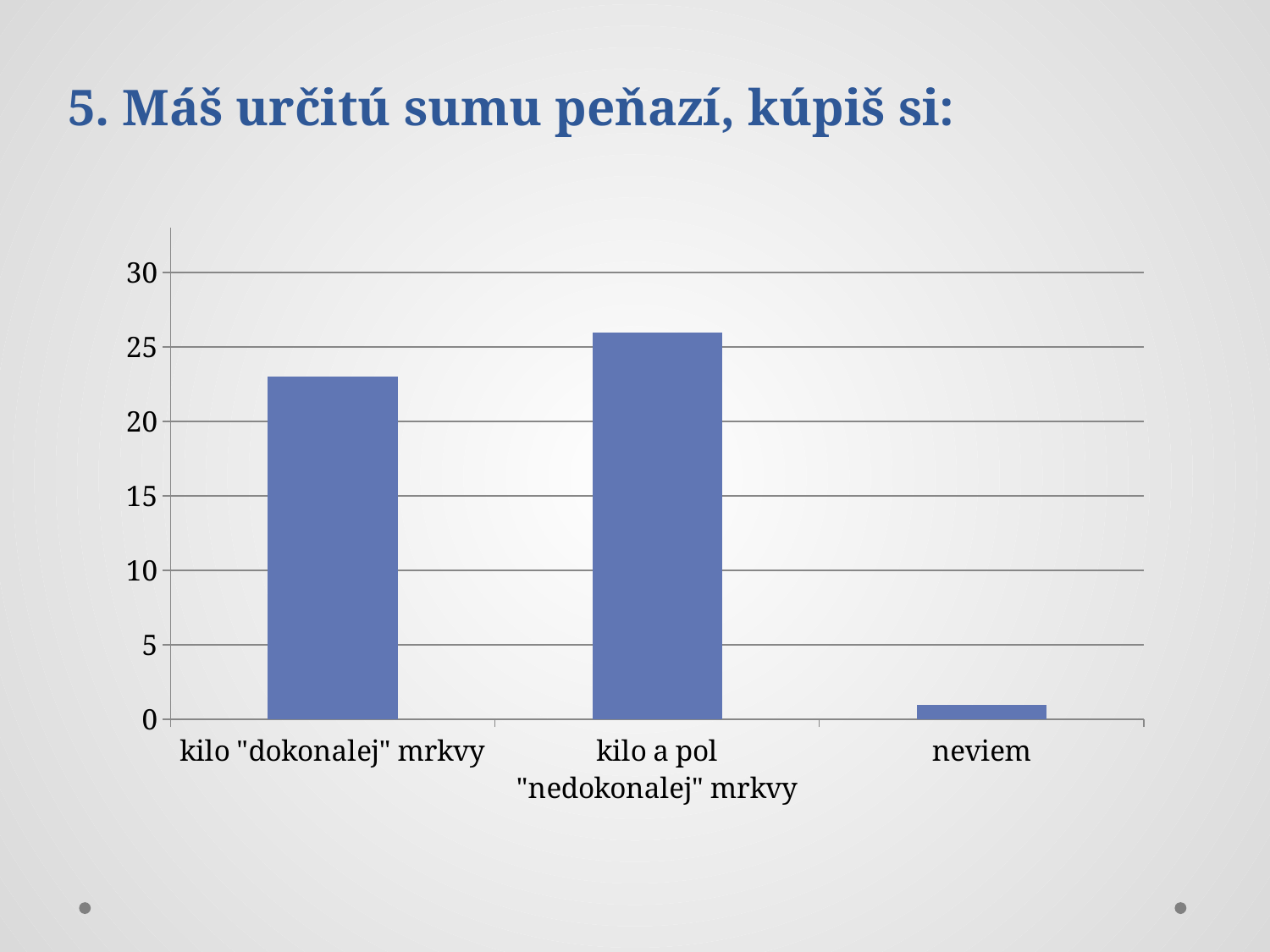
Is the value for kilo "dokonalej" mrkvy greater or less than 25? less Is the value for neviem greater or less than 5? less Which category has the highest bar? kilo a pol "nedokonalej" mrkvy How many categories are shown on the x axis of the chart? 3 Is the value for kilo "dokonalej" mrkvy greater or less than 20? greater What is the title of the slide containing the chart? 5. Máš určitú sumu peňazí, kúpiš si: Which category has the lowest bar? neviem Which is larger, the value for kilo "dokonalej" mrkvy or the value for kilo a pol "nedokonalej" mrkvy? kilo a pol "nedokonalej" mrkvy Which is larger, the value for kilo "dokonalej" mrkvy or the value for neviem? kilo "dokonalej" mrkvy What is the highest value shown on the y axis of the chart? 30 What kind of chart is shown on the slide? bar chart